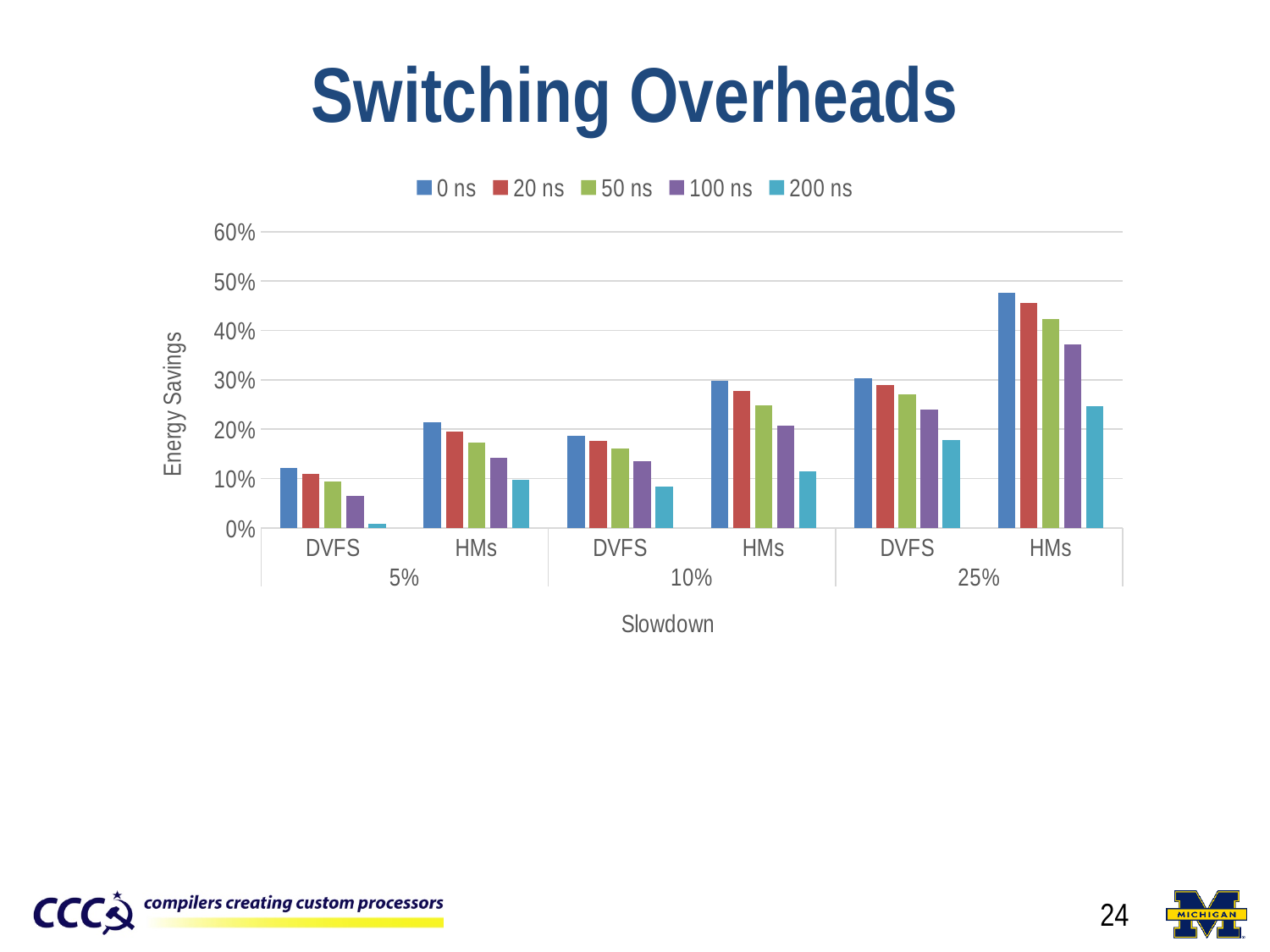
At 25% slowdown, which has the larger energy savings for 200 ns: DVFS or HMs? HMs What is the label on the y axis? Energy Savings Is the energy savings for 100 ns with HMs at 25% slowdown greater or less than 30%? greater At 5% slowdown, which has the larger energy savings for 0 ns: DVFS or HMs? HMs Is the energy savings for 0 ns with HMs at 25% slowdown greater or less than 40%? greater Which bar is the lowest in the chart? 200 ns for DVFS at 5% slowdown How many series does the legend list? 5 How many groups of bars (DVFS/HMs categories) are plotted along the x axis? 6 Within each group, how do energy savings change as the switching overhead increases from 0 ns to 200 ns? they fall Is the energy savings for 200 ns with DVFS at 5% slowdown greater or less than 10%? less Which bar is the highest in the chart? 0 ns for HMs at 25% slowdown What kind of chart is shown on the slide? bar chart